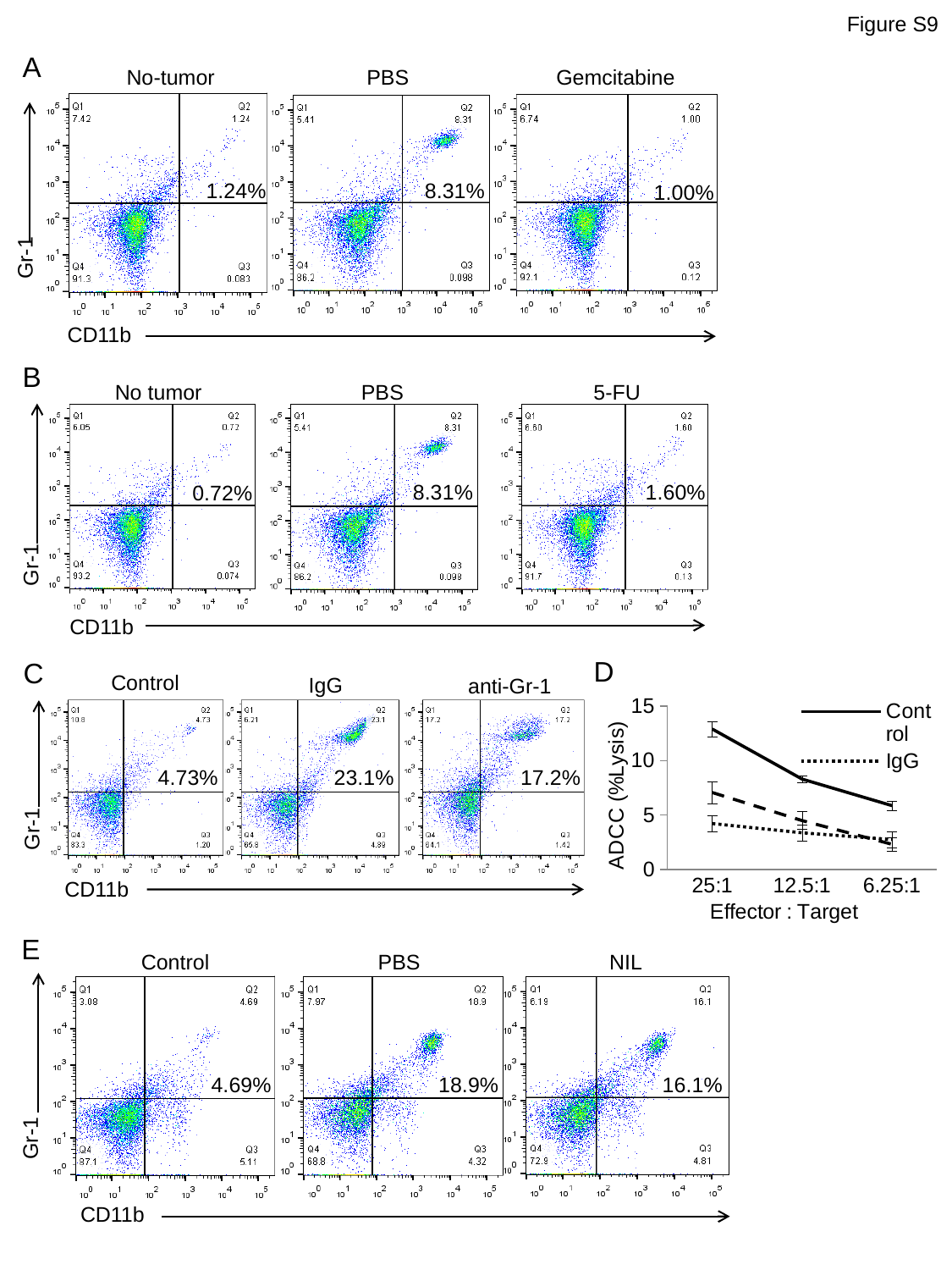
In panel A, which condition has the highest printed percentage? PBS In panel C, what percentage is printed on the IgG plot? 23.1% In panel D, does the Control line rise or fall from 25:1 to 6.25:1? fall In panel A, what percentage is printed on the Gemcitabine plot? 1.00% In panel B, which condition has the lowest printed percentage? No tumor In panel D, is the Control value at 25:1 greater or less than 10? greater In panel A, what percentage is printed on the PBS plot? 8.31% In panel E, which has the larger printed percentage, PBS or NIL? PBS In panel E, what percentage is printed on the Control plot? 4.69% What kind of chart is panel D? line chart In panel C, what is the difference between the IgG percentage and the anti-Gr-1 percentage? 5.9% In panel B, what percentage is printed on the 5-FU plot? 1.60%